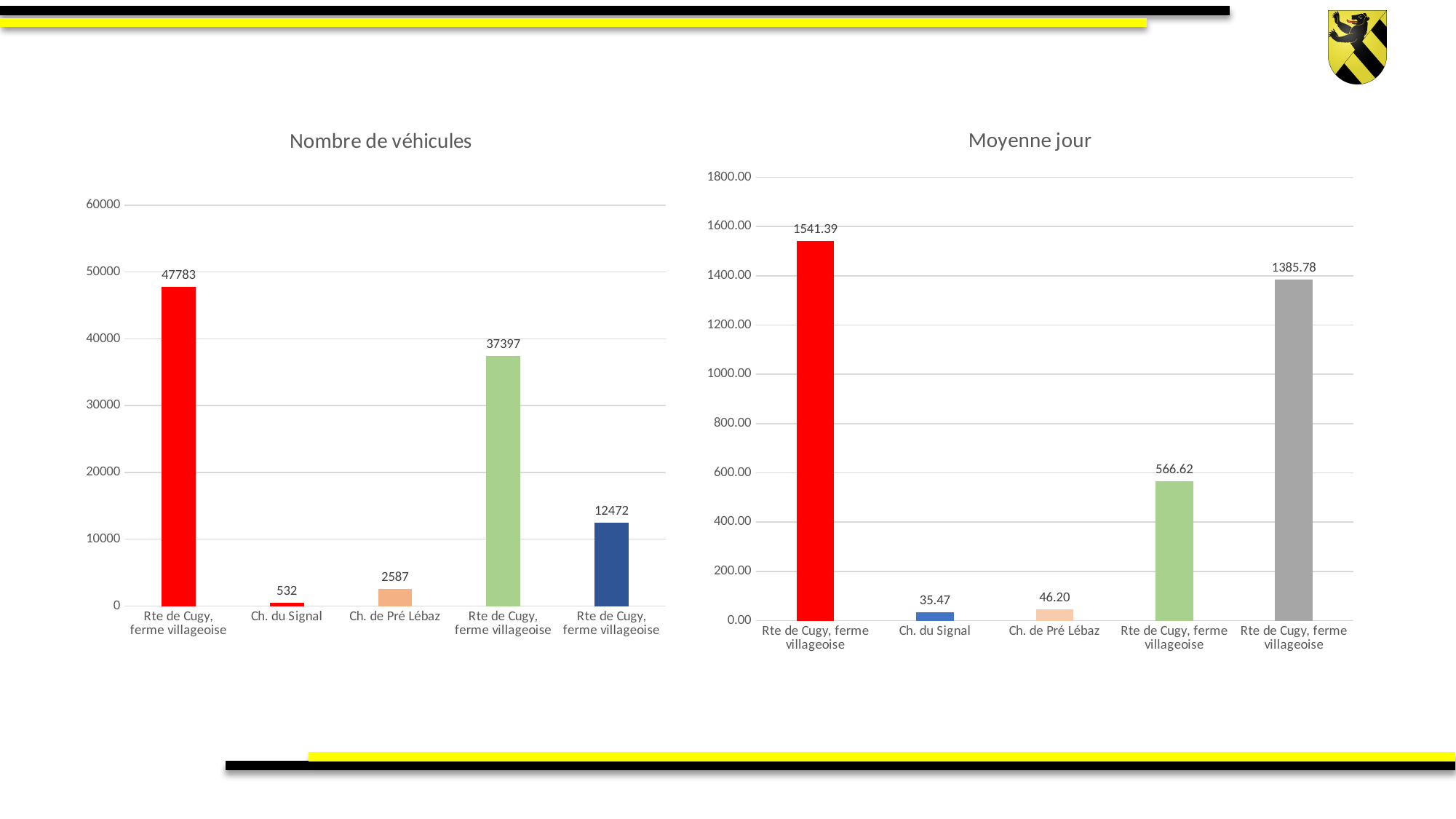
In the 'Nombre de véhicules' chart, what is the value of the first (leftmost) bar? 47783 In the 'Moyenne jour' chart, what is the value for Ch. de Pré Lébaz? 46.20 What type of chart is the 'Moyenne jour' chart? Bar chart In the 'Moyenne jour' chart, which is larger: the value for Ch. du Signal or the value for Ch. de Pré Lébaz? Ch. de Pré Lébaz In the 'Nombre de véhicules' chart, what is the value for Ch. de Pré Lébaz? 2587 In the 'Nombre de véhicules' chart, what is the value for Ch. du Signal? 532 In the 'Nombre de véhicules' chart, what is the difference between the first bar (47783) and the fourth bar (37397)? 10386 In the 'Nombre de véhicules' chart, how many bars are plotted? 5 In the 'Moyenne jour' chart, what is the value for Ch. du Signal? 35.47 In the 'Nombre de véhicules' chart, which bar has the lowest value? Ch. du Signal In the 'Moyenne jour' chart, what is the value of the last (rightmost) bar? 1385.78 In the 'Moyenne jour' chart, what is the difference between the first bar (1541.39) and the last bar (1385.78)? 155.61